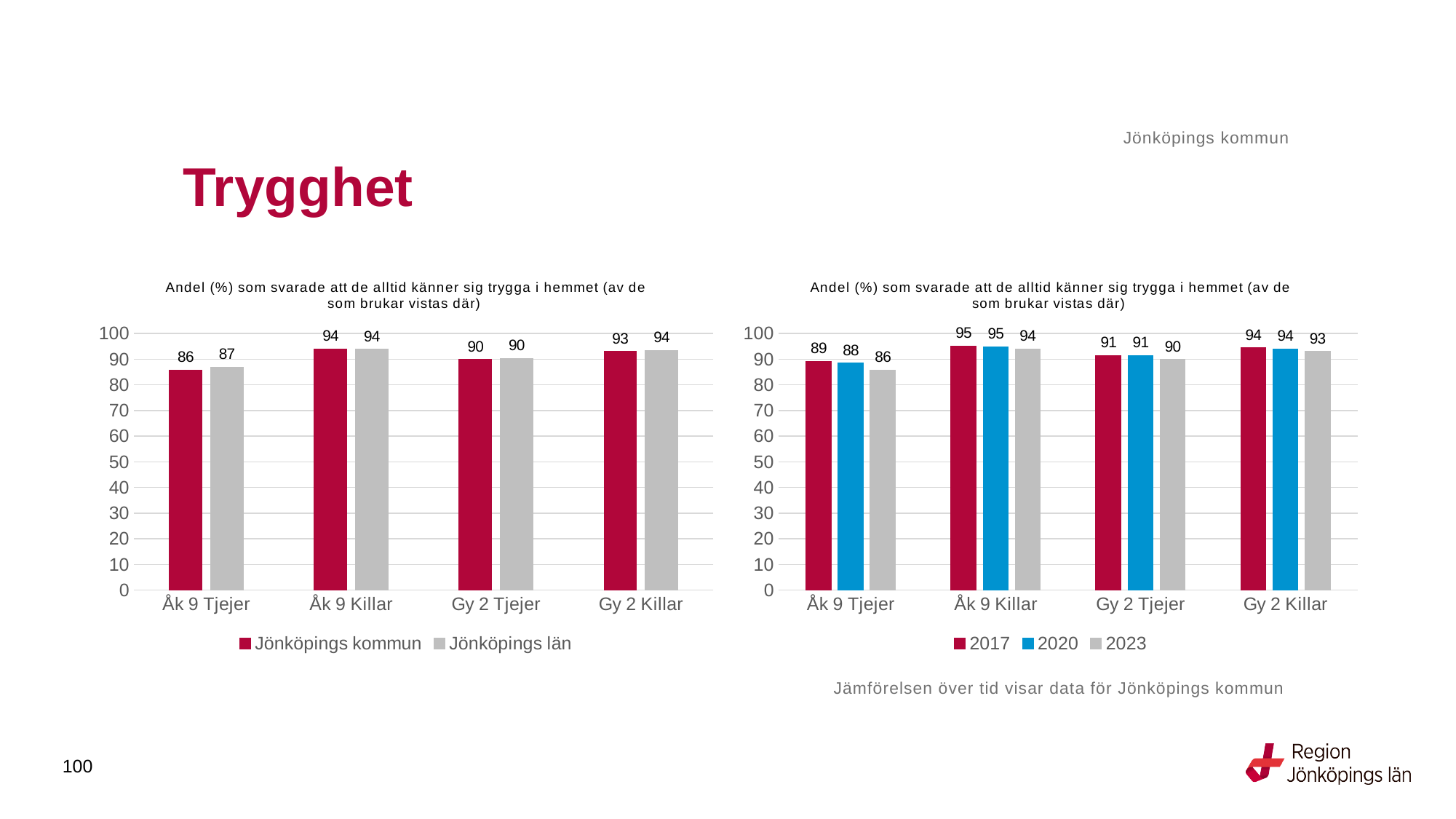
In the left chart, what is the value for Jönköpings kommun for Åk 9 Tjejer? 86 In the left chart, which category has the lowest value for Jönköpings kommun? Åk 9 Tjejer In the right chart, what is the value for 2017 for Gy 2 Tjejer? 91 In the left chart, how many series does the legend list? 2 In the right chart, how many categories are shown on the x axis? 4 In the left chart, what is the difference between Jönköpings län and Jönköpings kommun for Åk 9 Tjejer? 1 In the right chart, what is the value for 2023 for Åk 9 Tjejer? 86 In the left chart, what is the value for Jönköpings län for Gy 2 Killar? 94 In the right chart, how many series does the legend list? 3 What kind of chart is the left chart? Bar chart In the right chart, which category has the highest value for 2020? Åk 9 Killar In the right chart, what is the difference between the 2017 and 2023 values for Åk 9 Tjejer? 3